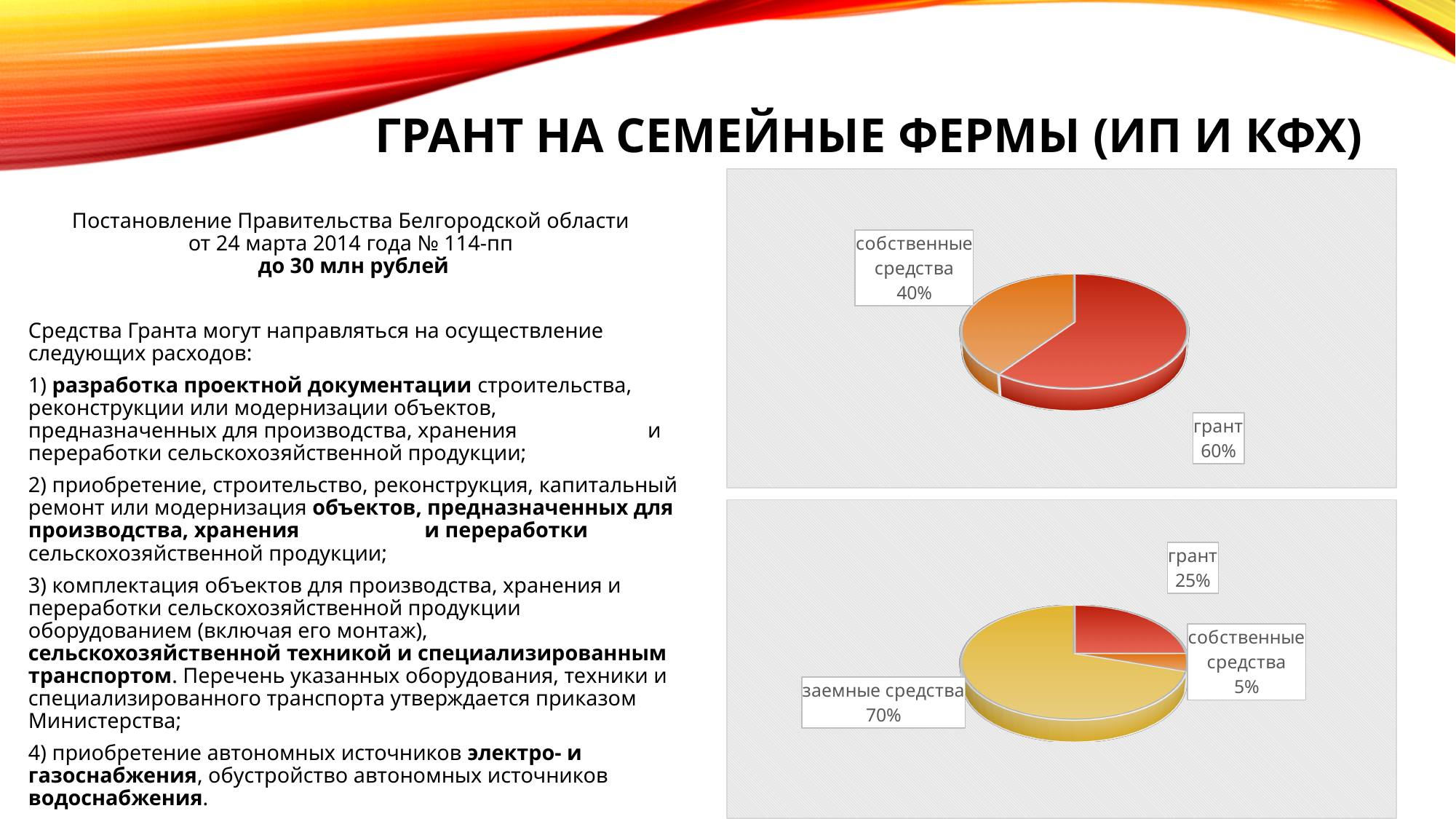
In the top pie chart, how many slices are there? 2 In the bottom pie chart, which slice is the smallest? собственные средства In the top pie chart, what share is labelled for грант? 60% In the top pie chart, what is the difference between the грант share and the собственные средства share? 20% In the bottom pie chart, what share is labelled for заемные средства? 70% In the bottom pie chart, what share is labelled for собственные средства? 5% In the top pie chart, what share is labelled for собственные средства? 40% In the top pie chart, which slice is the largest? грант In the bottom pie chart, how many slices are there? 3 In the bottom pie chart, which is larger: грант or собственные средства? грант What type of chart is shown at the top right of the slide? pie chart In the bottom pie chart, what share is labelled for грант? 25%